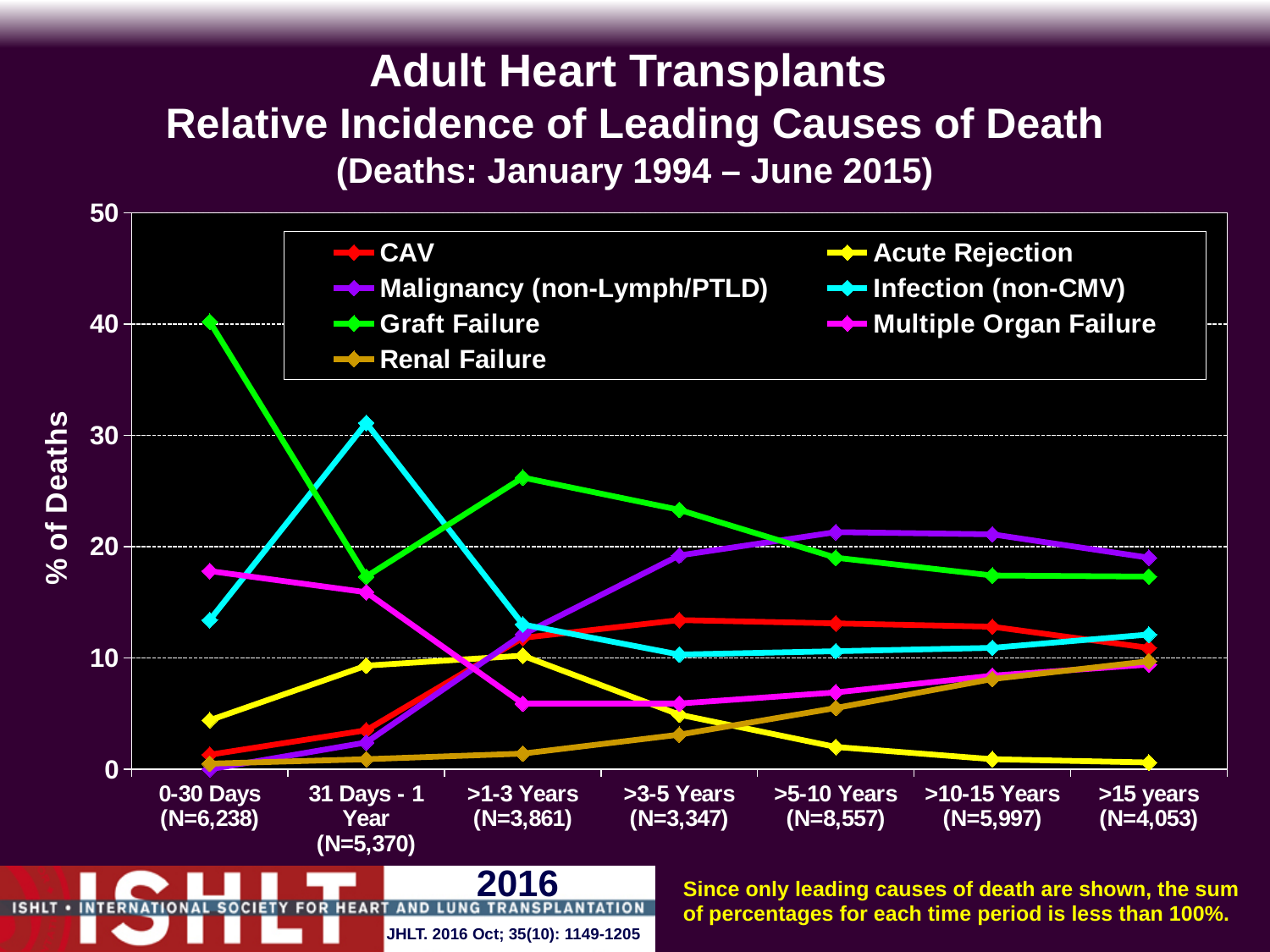
Does the Renal Failure line rise or fall across the time periods from 0-30 Days to >15 years? rise What kind of chart is shown on the slide? line chart Which cause of death has the lowest percentage in the >15 years period? Acute Rejection How many time-period categories are shown on the x axis? 7 Is the value for Graft Failure in the 0-30 Days period greater or less than 30? greater Is the value for Infection (non-CMV) in the 31 Days - 1 Year period greater or less than 20? greater What is the label on the y axis? % of Deaths In the 31 Days - 1 Year period, which is larger: Infection (non-CMV) or Graft Failure? Infection (non-CMV) Is the value for Multiple Organ Failure in the 0-30 Days period greater or less than 10? greater Which cause of death has the highest percentage in the >1-3 Years period? Graft Failure Which cause of death has the highest percentage in the 0-30 Days period? Graft Failure How many series does the legend list? 7